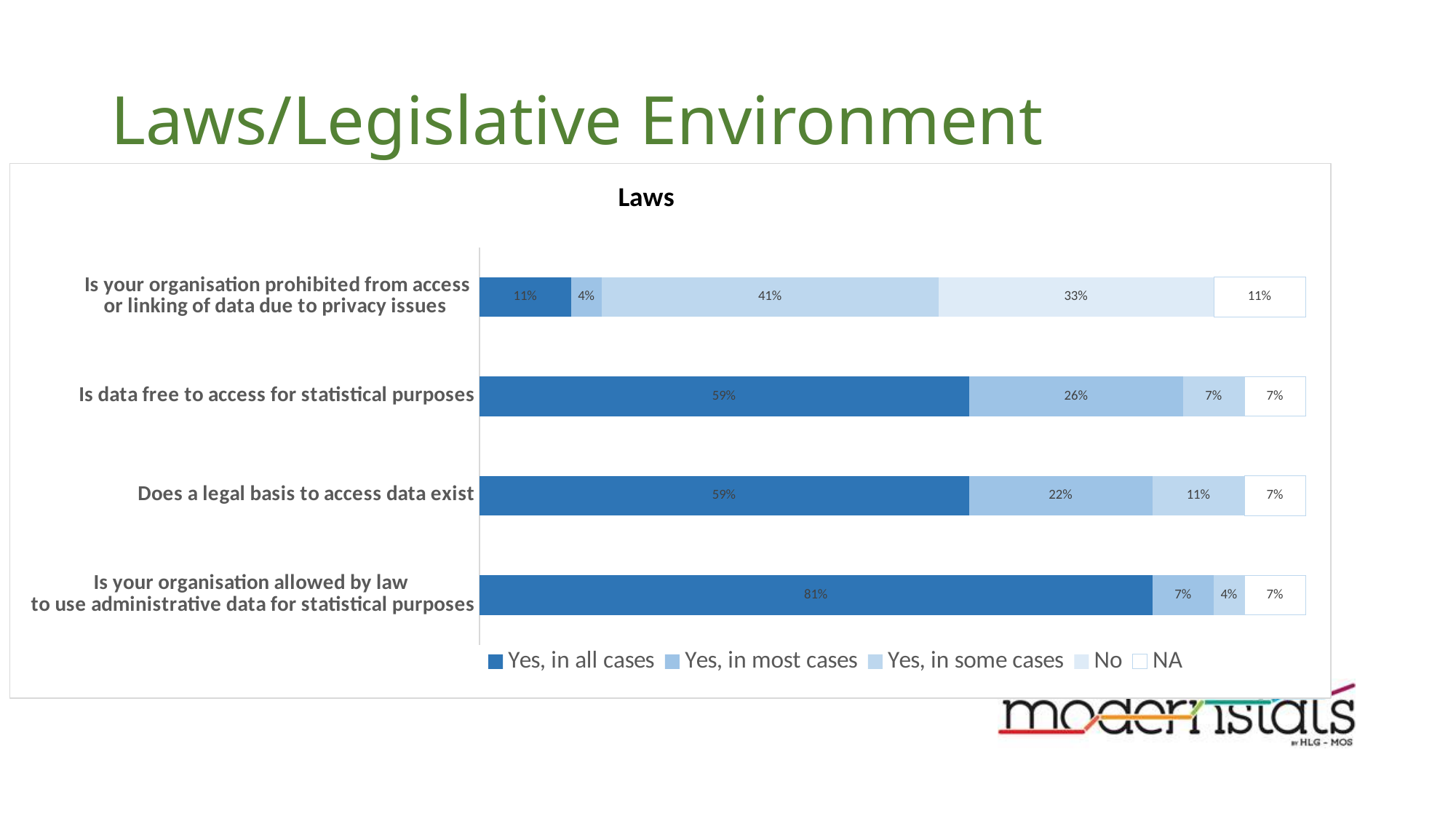
Which has a larger "Yes, in most cases" share: "Is data free to access for statistical purposes" or "Does a legal basis to access data exist"? Is data free to access for statistical purposes Which question has the lowest share of "Yes, in all cases" responses? Is your organisation prohibited from access or linking of data due to privacy issues How many percentage points higher is the "Yes, in all cases" share for "Is your organisation allowed by law to use administrative data for statistical purposes" than for "Does a legal basis to access data exist"? 22 percentage points What percentage answered "Yes, in most cases" to "Is your organisation prohibited from access or linking of data due to privacy issues"? 4% What percentage answered "Yes, in all cases" to "Is your organisation allowed by law to use administrative data for statistical purposes"? 81% What type of chart is shown on the slide? Stacked bar chart What percentage answered "No" to "Is your organisation prohibited from access or linking of data due to privacy issues"? 33% Which question has the highest share of "Yes, in all cases" responses? Is your organisation allowed by law to use administrative data for statistical purposes How many response categories does the legend list? 5 What is the title of the chart? Laws How many questions (categories) are shown in the chart? 4 What percentage answered "Yes, in some cases" to "Is your organisation prohibited from access or linking of data due to privacy issues"? 41%